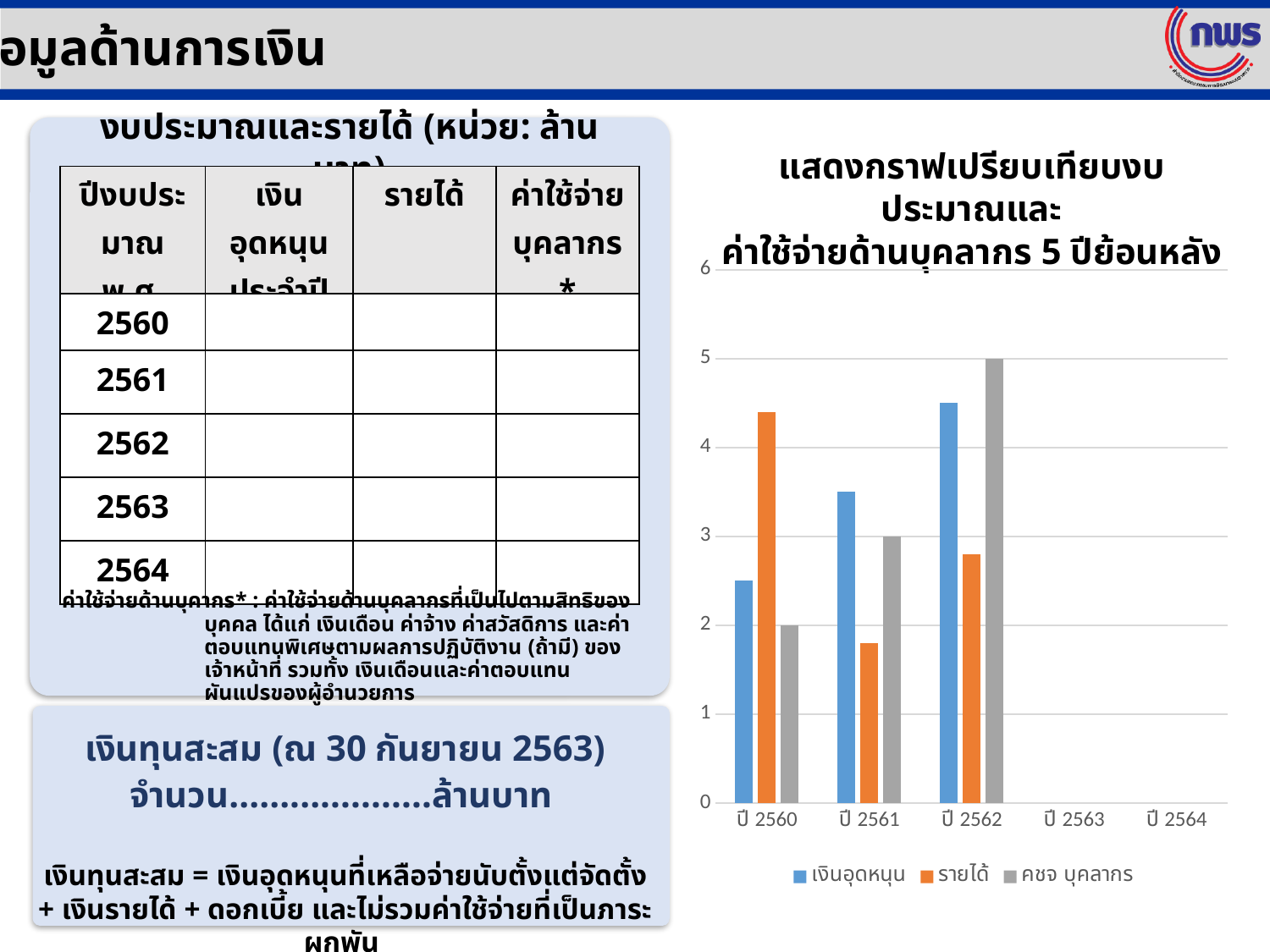
In the bar chart, is the value of เงินอุดหนุน for ปี 2562 greater or less than 4? greater What colour represents รายได้ in the bar chart legend? orange What kind of chart is shown on the right side of the slide? bar chart How many series does the legend of the bar chart list? 3 In the bar chart, for ปี 2560, which is larger: เงินอุดหนุน or รายได้? รายได้ In the bar chart, is the value of รายได้ for ปี 2561 greater or less than 2? less In the bar chart, which year has the lowest รายได้ bar among the years with data? ปี 2561 In the bar chart, which year has the highest รายได้ bar? ปี 2560 In the bar chart, which year has the highest คชจ บุคลากร bar? ปี 2562 How many year categories are shown on the x axis of the bar chart? 5 Which years on the x axis of the bar chart have no bars plotted? ปี 2563 and ปี 2564 In the bar chart, does เงินอุดหนุน rise or fall from ปี 2560 to ปี 2562? rise